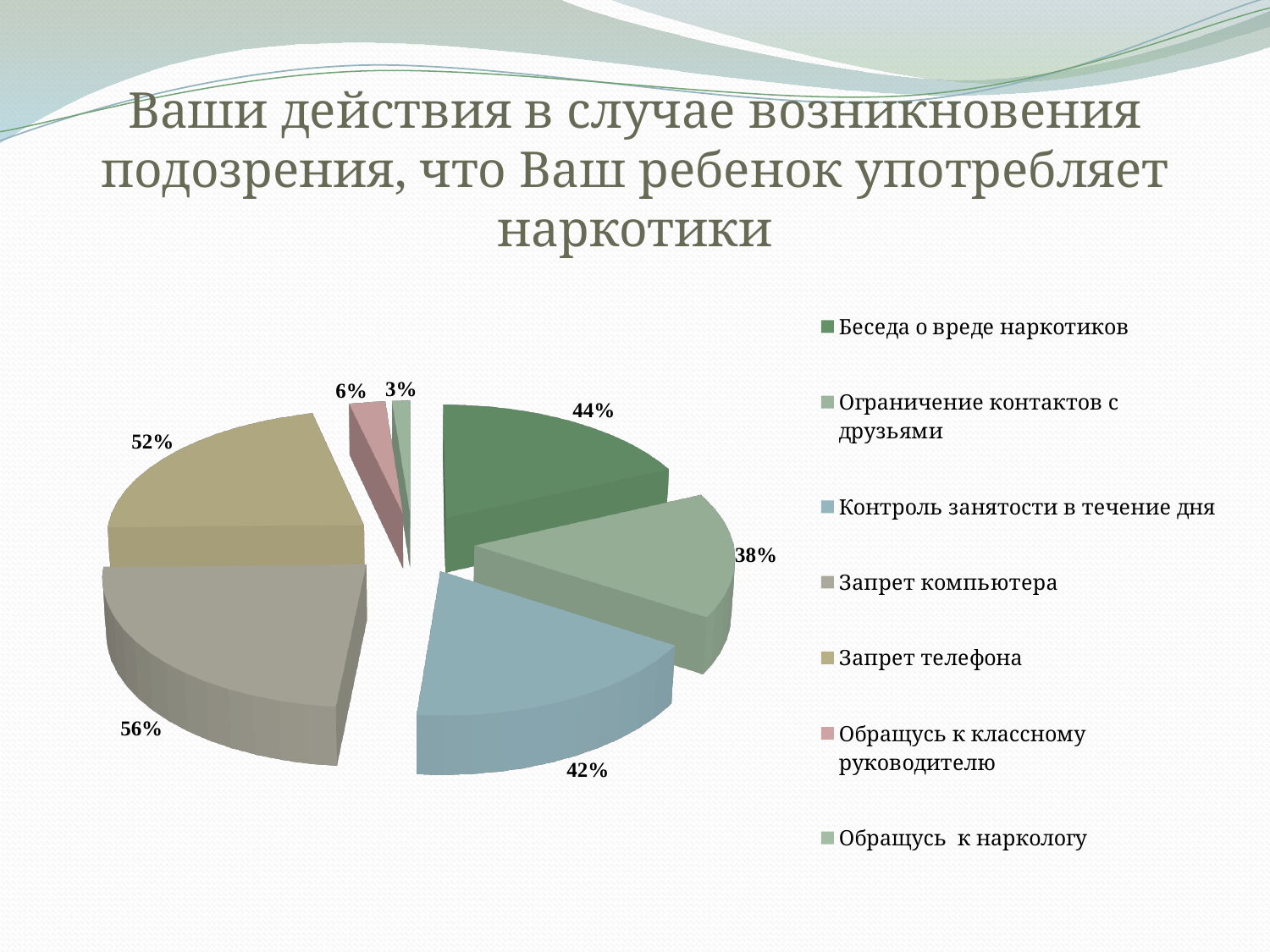
What is the difference between the values for "Запрет компьютера" and "Ограничение контактов с друзьями"? 18% What is the value shown for "Контроль занятости в течение дня"? 42% How many categories does the legend list? 7 Which category has the largest slice? Запрет компьютера What is the value shown for "Обращусь к наркологу"? 3% What is the value shown for "Запрет компьютера"? 56% What kind of chart is shown on the slide? pie chart Which is larger: "Беседа о вреде наркотиков" or "Контроль занятости в течение дня"? Беседа о вреде наркотиков What is the value shown for "Запрет телефона"? 52% What is the value shown for "Обращусь к классному руководителю"? 6% Which category has the smallest slice? Обращусь к наркологу What is the value shown for "Беседа о вреде наркотиков"? 44%